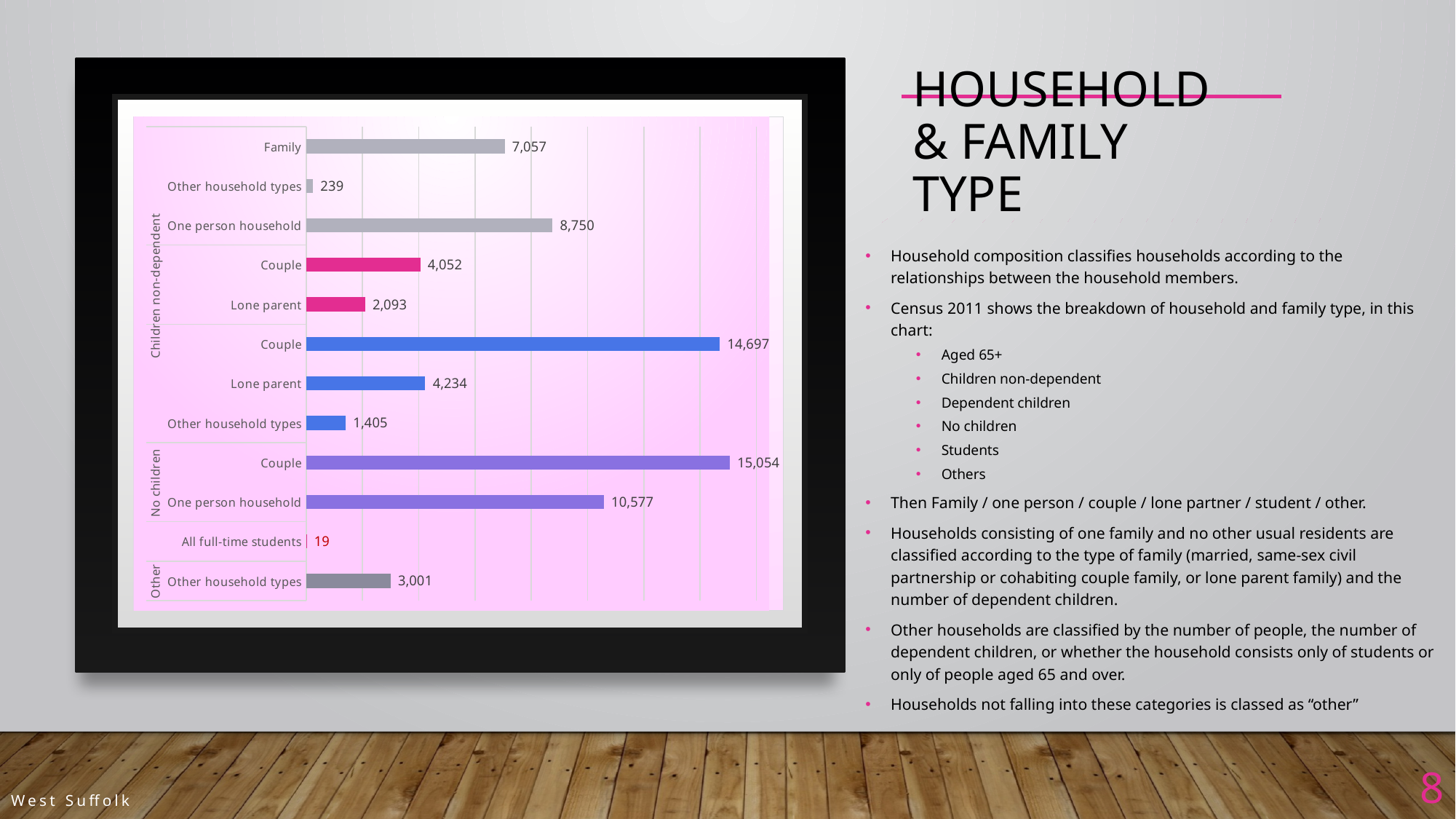
What is the value for Family in the chart? 7,057 What is the value for One person household in the No children group? 10,577 Which category has the lowest value in the chart? All full-time students What is the value for Other household types in the Other group? 3,001 What is the value for All full-time students? 19 How many bars are plotted in the chart? 12 What colour are the bars for Couple and Lone parent in the Children non-dependent group? pink What is the value for Couple in the No children group? 15,054 What type of chart is shown on the slide? bar chart What is the difference between the Couple bar in the No children group (15,054) and the blue Couple bar (14,697)? 357 Which category has the highest value in the chart? Couple (No children) Which is larger: the One person household bar in the No children group or the grey One person household bar above it? One person household (No children)